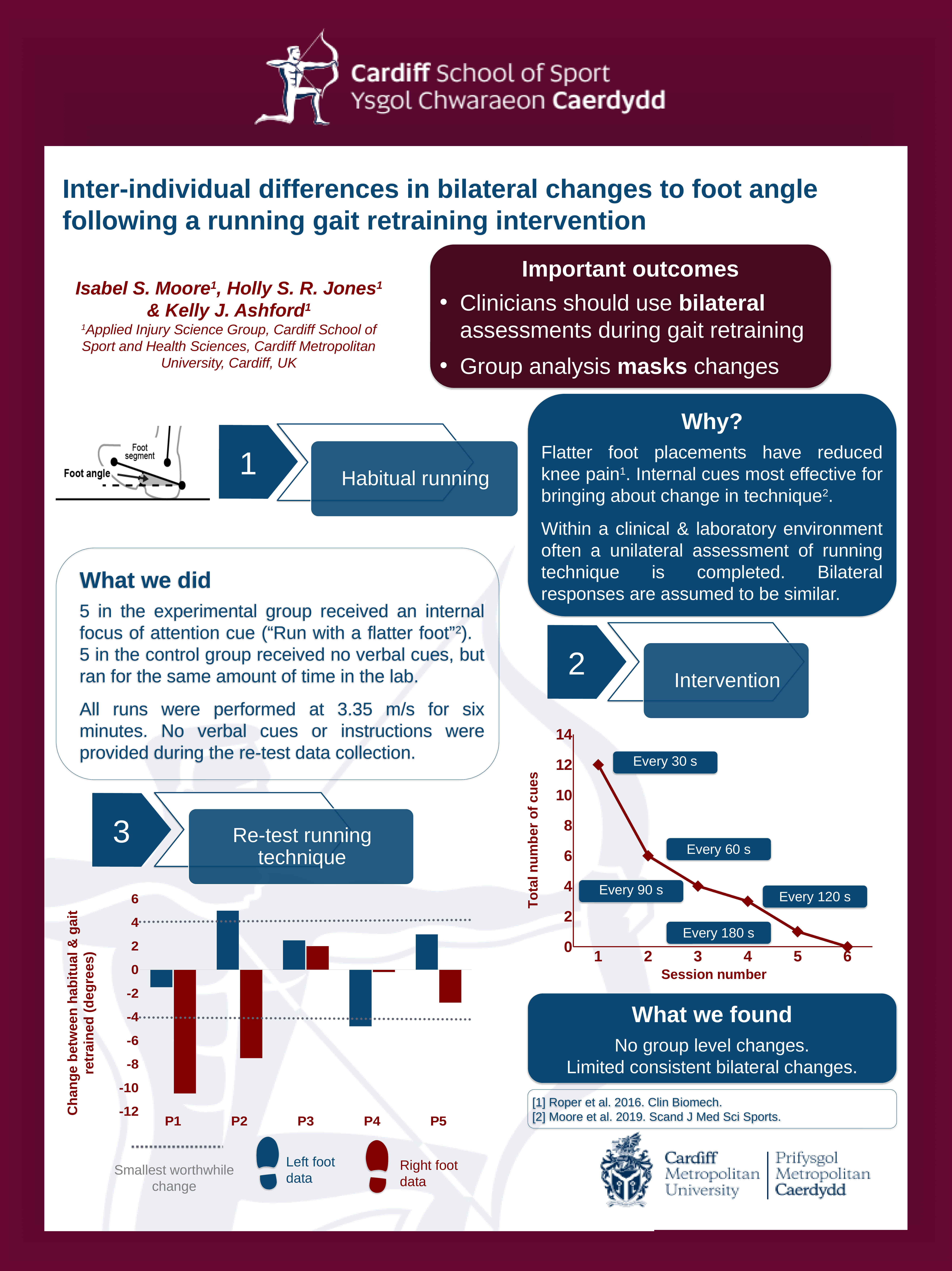
On the line chart of total number of cues, how many sessions are plotted? 6 On the line chart of total number of cues, what is the total number of cues at session 2? 6 On the line chart of total number of cues, do the values rise or fall as the session number increases? fall On the line chart of total number of cues, what is the total number of cues at session 6? 0 On the bar chart of change between habitual and gait retrained foot angle, is the right foot value for P1 greater or less than -8? less On the line chart of total number of cues, what is the total number of cues at session 1? 12 On the line chart of total number of cues, which session number has the highest total number of cues? 1 On the bar chart of change between habitual and gait retrained foot angle, which participant has the lowest right foot value? P1 On the bar chart of change between habitual and gait retrained foot angle, how many participants are shown on the x axis? 5 On the bar chart of change between habitual and gait retrained foot angle, how many series does the legend list? 2 What kind of chart shows the change between habitual and gait retrained foot angle for P1 to P5? bar chart On the line chart of total number of cues, what is the difference between the total number of cues at session 1 and at session 2? 6